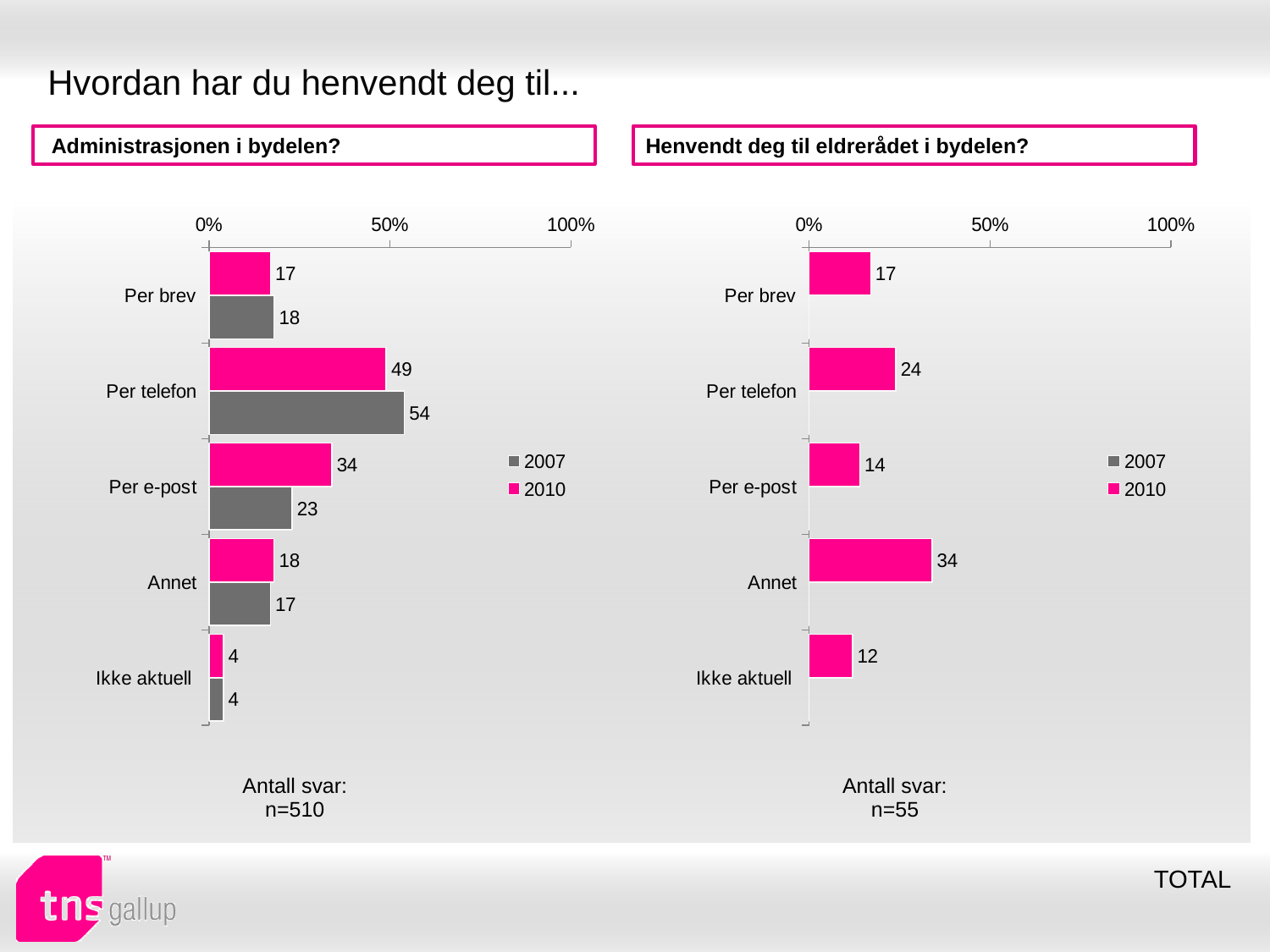
In the 'Henvendt deg til eldrerådet i bydelen?' chart, what is the 2010 value for Annet? 34 In the 'Henvendt deg til eldrerådet i bydelen?' chart, is the value for Per telefon greater or less than 50%? less In the 'Administrasjonen i bydelen?' chart, which is larger for Per e-post: the 2007 value or the 2010 value? 2010 In the 'Henvendt deg til eldrerådet i bydelen?' chart, which category has the lowest value? Ikke aktuell How many categories are shown in the 'Administrasjonen i bydelen?' chart? 5 In the 'Administrasjonen i bydelen?' chart, what is the 2007 value for Per e-post? 23 In the 'Henvendt deg til eldrerådet i bydelen?' chart, what is the value for Ikke aktuell? 12 In the 'Administrasjonen i bydelen?' chart, what is the difference between the 2007 and 2010 values for Per telefon? 5 What type of chart is the 'Administrasjonen i bydelen?' chart? Bar chart How many series does the legend of the 'Henvendt deg til eldrerådet i bydelen?' chart list? 2 In the 'Administrasjonen i bydelen?' chart, what is the 2010 value for Per telefon? 49 In the 'Administrasjonen i bydelen?' chart, which category has the highest 2007 value? Per telefon